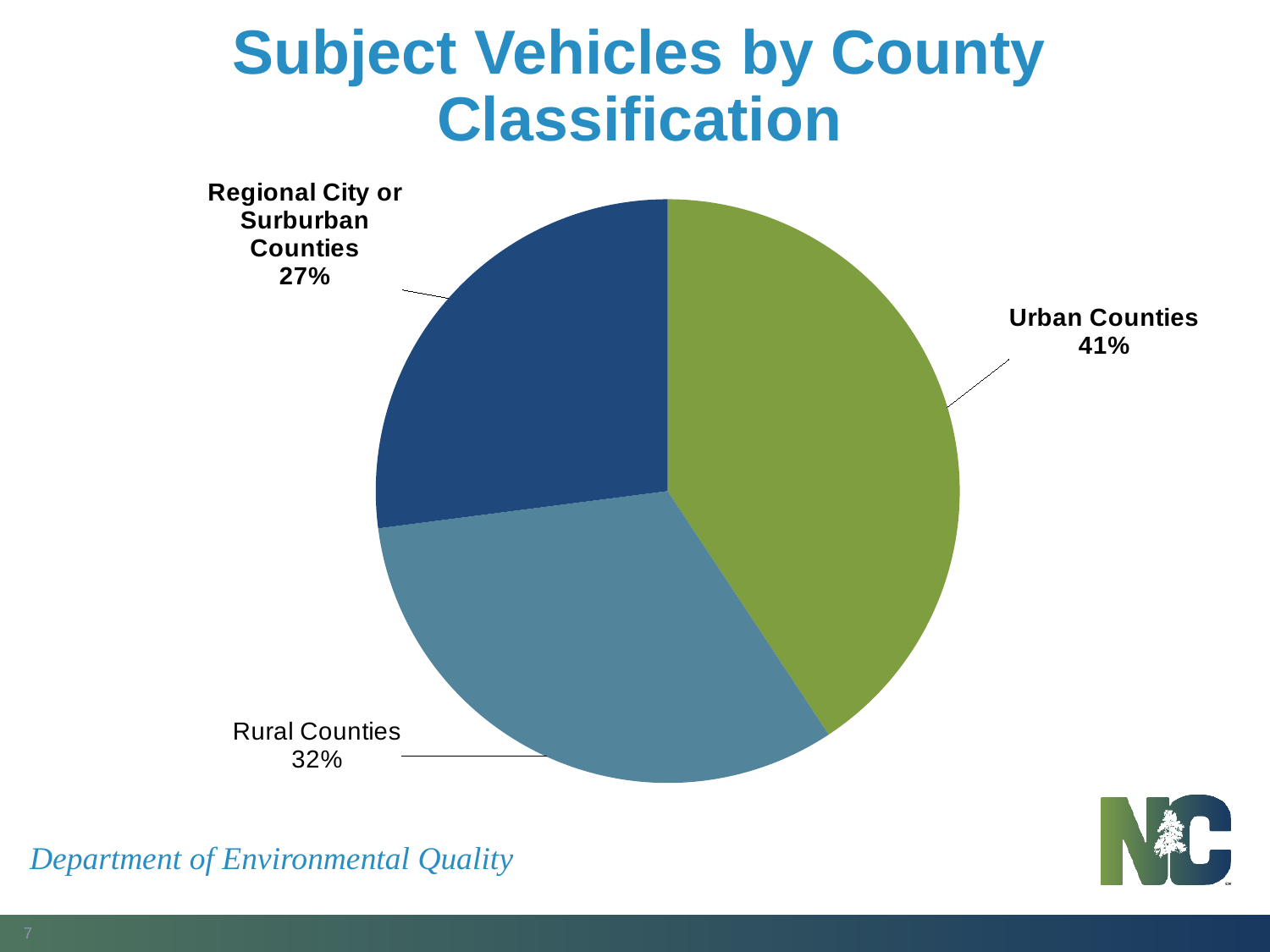
What is the difference in percentage points between Urban Counties and Rural Counties? 9 What colour is the Urban Counties slice? green What type of chart is shown on the slide? pie chart Which county classification has the largest share of subject vehicles? Urban Counties Which has a larger share, Rural Counties or Regional City or Surburban Counties? Rural Counties What share of subject vehicles is in Rural Counties? 32% How many slices does the pie chart have? 3 What share of subject vehicles is in Urban Counties? 41% What is the difference in percentage points between Rural Counties and Regional City or Surburban Counties? 5 What is the title of the chart? Subject Vehicles by County Classification Which county classification has the smallest share of subject vehicles? Regional City or Surburban Counties What share of subject vehicles is in Regional City or Surburban Counties? 27%